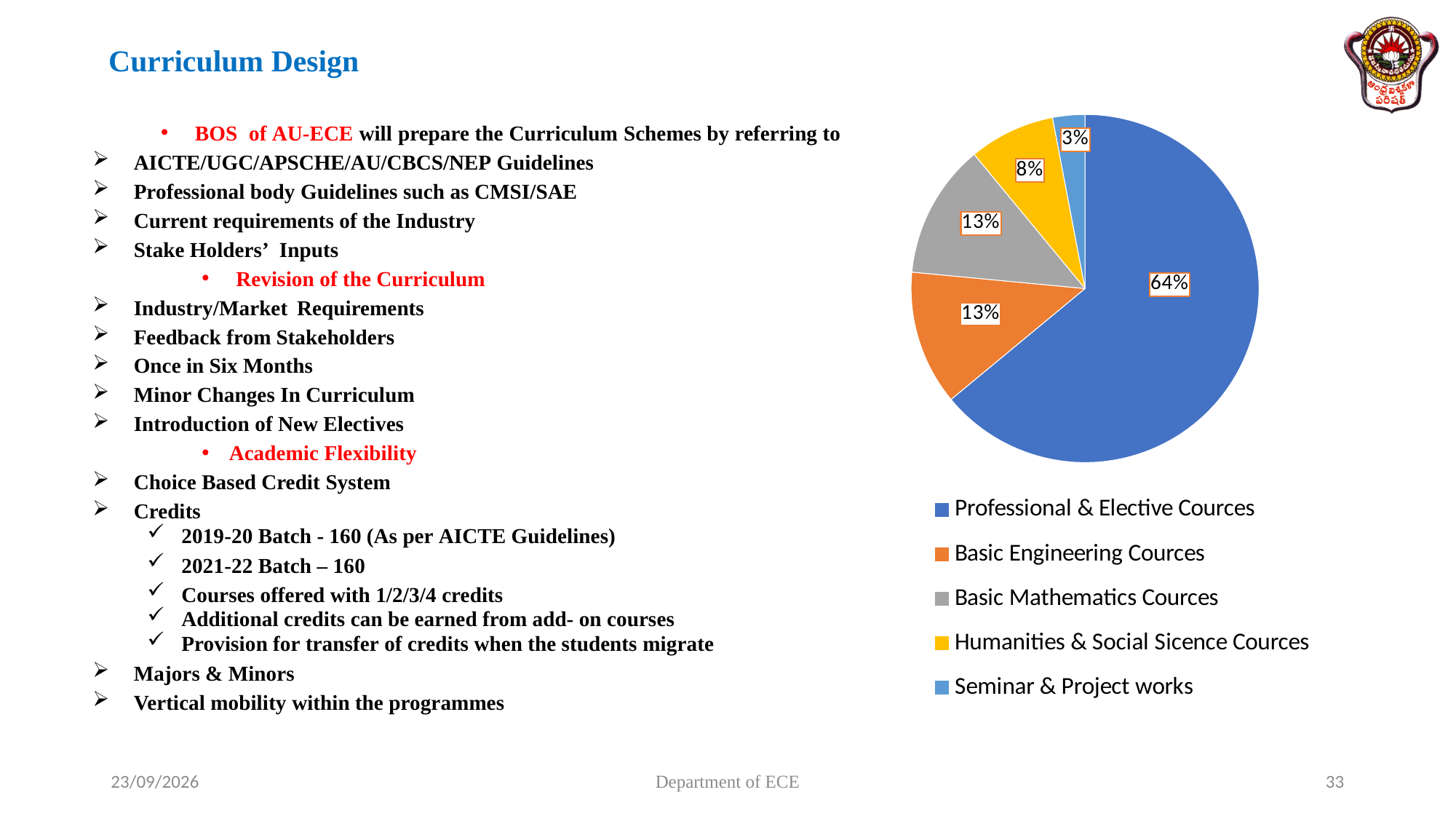
What share of the pie chart is Basic Engineering Cources? 13% What share of the pie chart is Humanities & Social Sicence Cources? 8% What type of chart is shown on the slide? Pie chart What share of the pie chart is Seminar & Project works? 3% What is the difference in percentage points between Professional & Elective Cources and Basic Mathematics Cources? 51 Which category has the smallest slice in the pie chart? Seminar & Project works Which is larger in the pie chart: Humanities & Social Sicence Cources or Seminar & Project works? Humanities & Social Sicence Cources What is the combined share of Basic Engineering Cources and Basic Mathematics Cources? 26% Which category has the largest slice in the pie chart? Professional & Elective Cources What colour is the slice for Humanities & Social Sicence Cources in the pie chart? Yellow How many categories does the pie chart show? 5